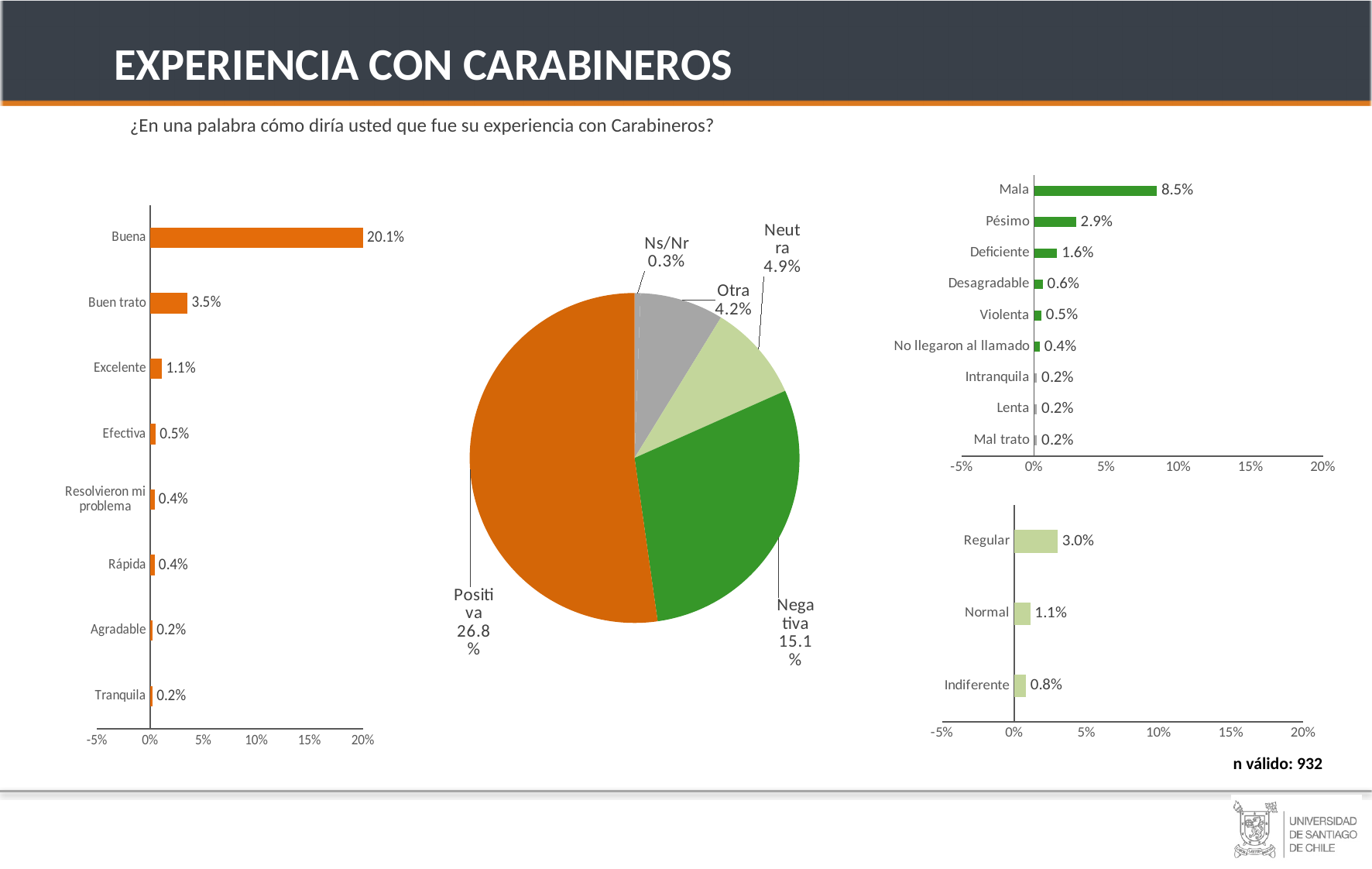
In the orange bar chart on the left, which category has the highest value? Buena In the pie chart in the center, what is the value for Negativa? 15.1% In the green bar chart at the top right, is the value for Mala greater or less than 5%? greater In the pie chart in the center, which slice is the smallest? Ns/Nr In the green bar chart at the top right, which category has the highest value? Mala In the orange bar chart on the left, what is the difference between Buena and Buen trato? 16.6% How many categories are shown in the orange bar chart on the left? 8 What kind of chart is the chart in the center of the slide? Pie chart In the light green bar chart at the bottom right, which is larger, Regular or Normal? Regular In the pie chart in the center, what share does the Positiva slice have? 26.8% In the green bar chart at the top right, what is the value for Pésimo? 2.9% In the orange bar chart on the left, what is the value for Buena? 20.1%